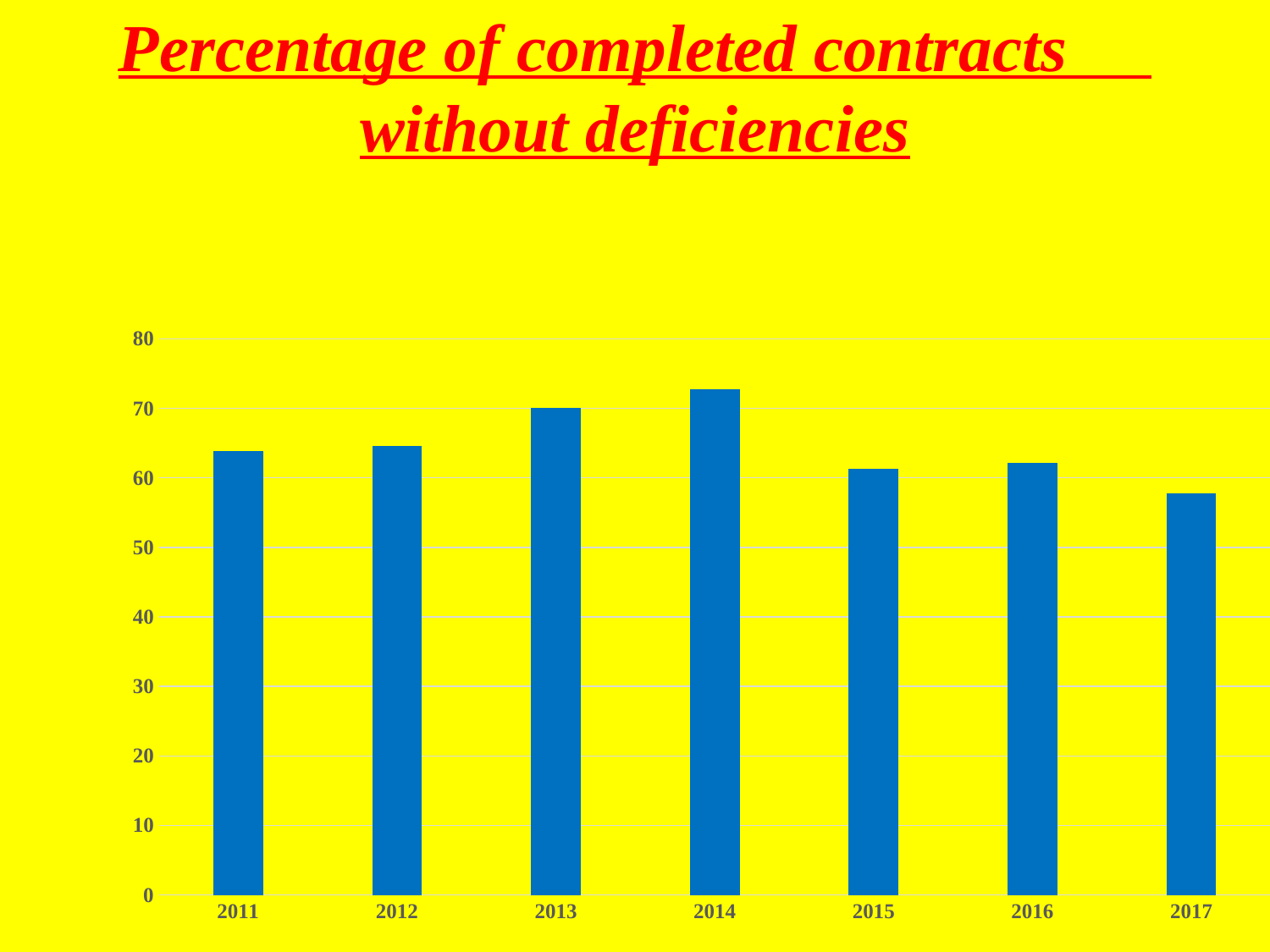
Which year has the highest percentage of completed contracts without deficiencies? 2014 Is the value for 2012 greater or less than 70? less What kind of chart is shown on the slide? Bar chart Is the value for 2014 greater or less than 70? greater Is the value for 2013 greater or less than 60? greater Do the values rise or fall from 2014 to 2017? fall How many years are shown on the x axis of the chart? 7 What is the title of the chart on the slide? Percentage of completed contracts without deficiencies Which year has a higher value, 2017 or 2014? 2014 Which year has the lowest percentage of completed contracts without deficiencies? 2017 Which year has a higher value, 2013 or 2015? 2013